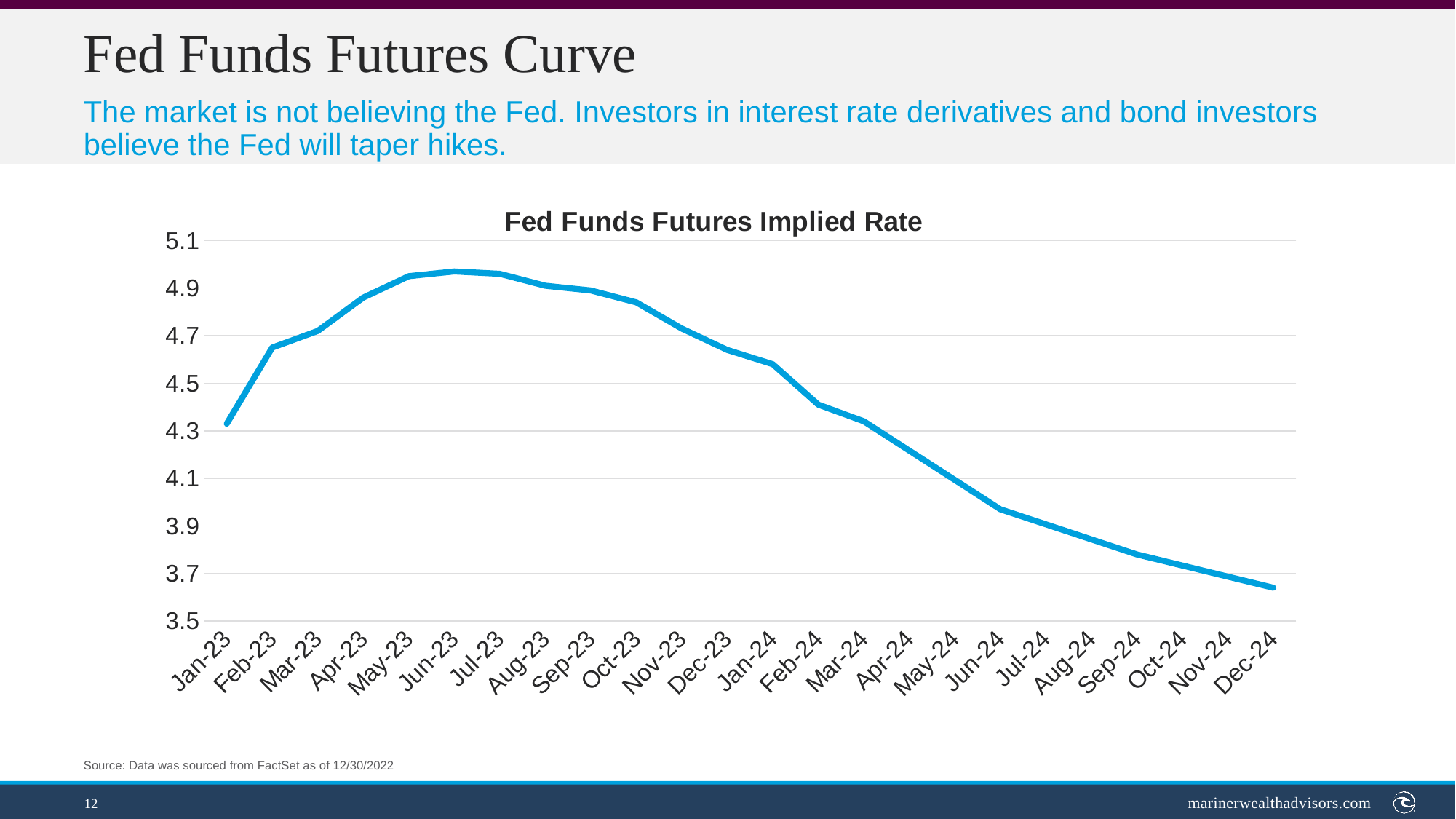
Do the values rise or fall from Jul-23 to Dec-24? fall What is the title of the chart? Fed Funds Futures Implied Rate Is the value for Dec-24 greater or less than 3.7? less Do the values rise or fall from Jan-23 to May-23? rise How many months are plotted along the x axis? 24 What kind of chart is shown on the slide? line chart Which is larger, the value for Jan-23 or the value for Dec-24? Jan-23 Is the value for Jan-23 greater or less than 4.5? less Is the value for Jun-24 greater or less than 3.9? greater Which month has the lowest implied rate? Dec-24